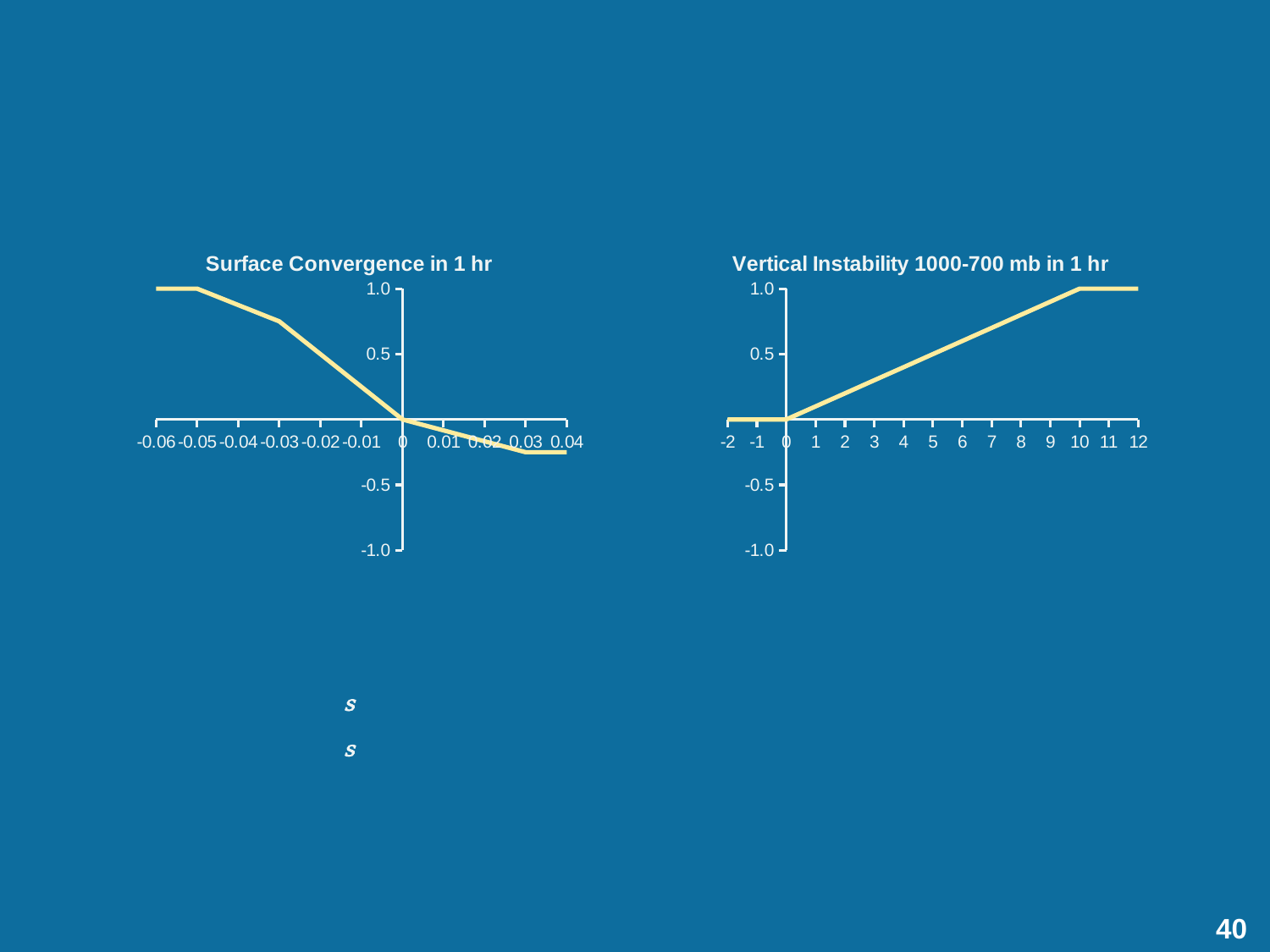
In the 'Vertical Instability 1000-700 mb in 1 hr' chart, is the value at x = 8 greater or less than 0.5? greater What is the title of the chart on the right side of the slide? Vertical Instability 1000-700 mb in 1 hr In the 'Surface Convergence in 1 hr' chart, what is the value of the line at x = -0.06? 1.0 In the 'Surface Convergence in 1 hr' chart, what is the value of the line at x = 0? 0 In the 'Surface Convergence in 1 hr' chart, is the value at x = 0.03 greater or less than 0? less In the 'Surface Convergence in 1 hr' chart, is the value at x = -0.03 greater or less than 0.5? greater In the 'Vertical Instability 1000-700 mb in 1 hr' chart, do the values rise or fall as you move from left to right along the x axis? rise In the 'Vertical Instability 1000-700 mb in 1 hr' chart, what is the value of the line at x = -2? 0 In the 'Surface Convergence in 1 hr' chart, do the values rise or fall as you move from left to right along the x axis? fall In the 'Vertical Instability 1000-700 mb in 1 hr' chart, what is the value of the line at x = 10? 1.0 What kind of chart is the 'Surface Convergence in 1 hr' chart? line chart What kind of chart is the 'Vertical Instability 1000-700 mb in 1 hr' chart? line chart